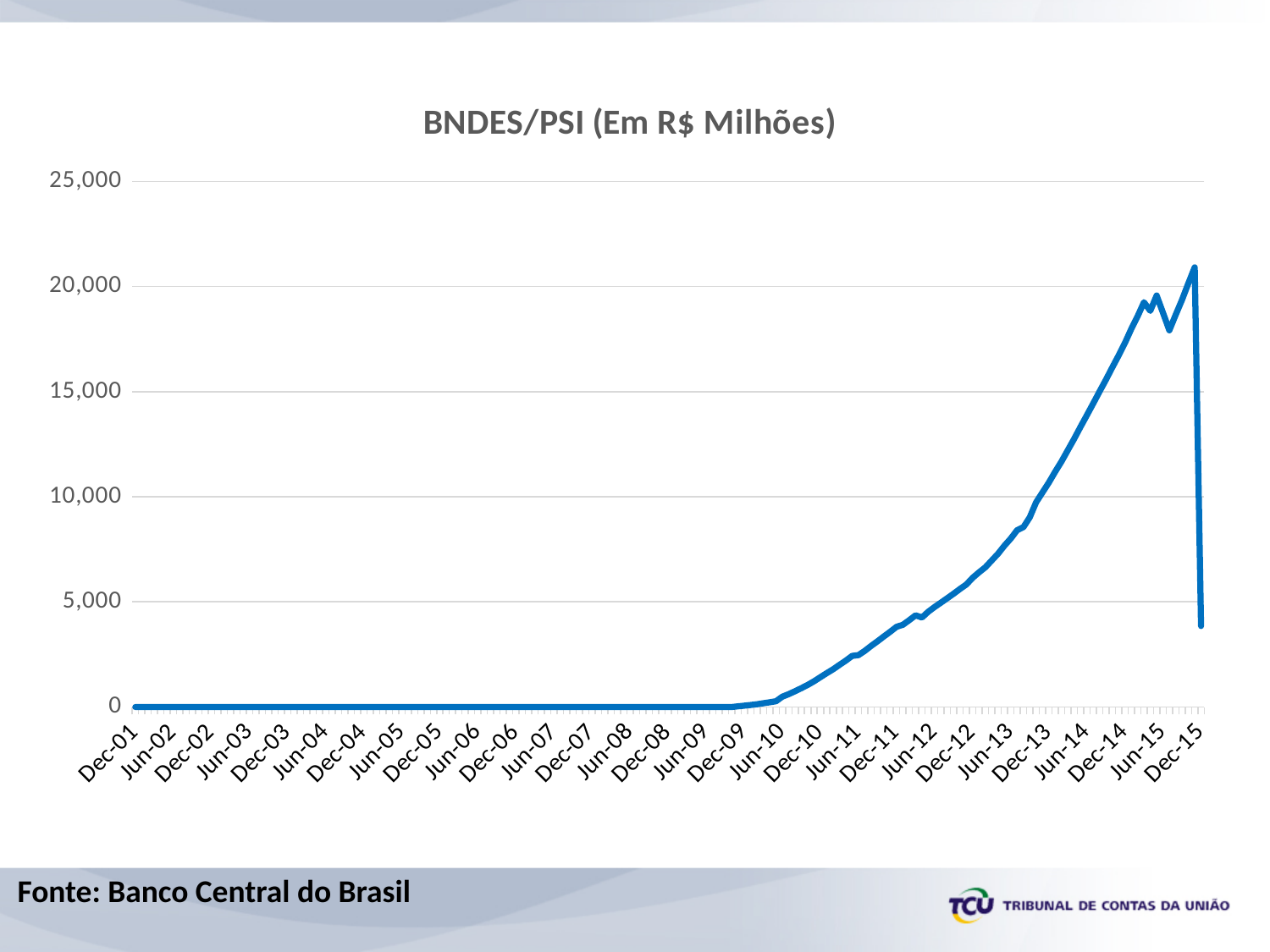
Is the value for Dec-14 greater or less than 15,000? greater Is the peak value of the line greater or less than 20,000? greater What is the title of the chart? BNDES/PSI (Em R$ Milhões) Is the value for Jun-14 greater or less than 15,000? less What kind of chart is shown on the slide? line chart What is the highest value shown on the y axis? 25,000 Does the line rise or fall between Dec-09 and Dec-14? rise Which is larger, the value for Dec-14 or the value for Dec-11? Dec-14